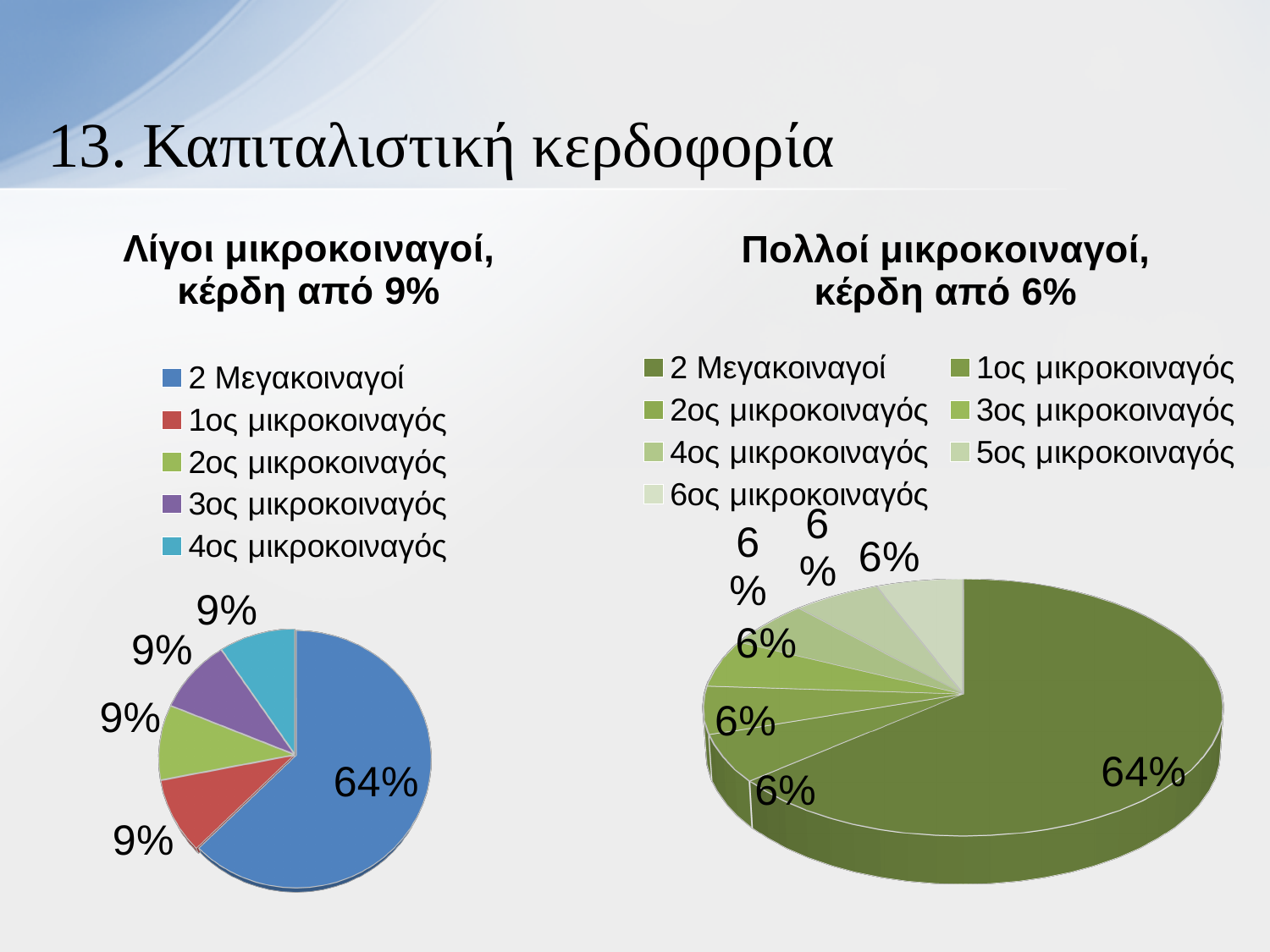
In the right chart ("Πολλοί μικροκοιναγοί, κέρδη από 6%"), which category has the largest slice? 2 Μεγακοιναγοί In the right chart ("Πολλοί μικροκοιναγοί, κέρδη από 6%"), what share is labelled for "2 Μεγακοιναγοί"? 64% What kind of chart is the left chart titled "Λίγοι μικροκοιναγοί, κέρδη από 9%"? Pie chart What colour is the "2 Μεγακοιναγοί" slice in the left chart ("Λίγοι μικροκοιναγοί, κέρδη από 9%")? Blue In the left chart ("Λίγοι μικροκοιναγοί, κέρδη από 9%"), what share of the pie is labelled for "2 Μεγακοιναγοί"? 64% In the right chart ("Πολλοί μικροκοιναγοί, κέρδη από 6%"), what share is labelled for "4ος μικροκοιναγός"? 6% In the left chart ("Λίγοι μικροκοιναγοί, κέρδη από 9%"), which category has the largest slice? 2 Μεγακοιναγοί How many entries does the legend of the left chart ("Λίγοι μικροκοιναγοί, κέρδη από 9%") list? 5 In the left chart ("Λίγοι μικροκοιναγοί, κέρδη από 9%"), what is the difference between the share for "2 Μεγακοιναγοί" and the share for "3ος μικροκοιναγός"? 55% How many slices does the right chart ("Πολλοί μικροκοιναγοί, κέρδη από 6%") have? 7 In the right chart ("Πολλοί μικροκοιναγοί, κέρδη από 6%"), what is the difference between the share for "2 Μεγακοιναγοί" and the share for "1ος μικροκοιναγός"? 58%